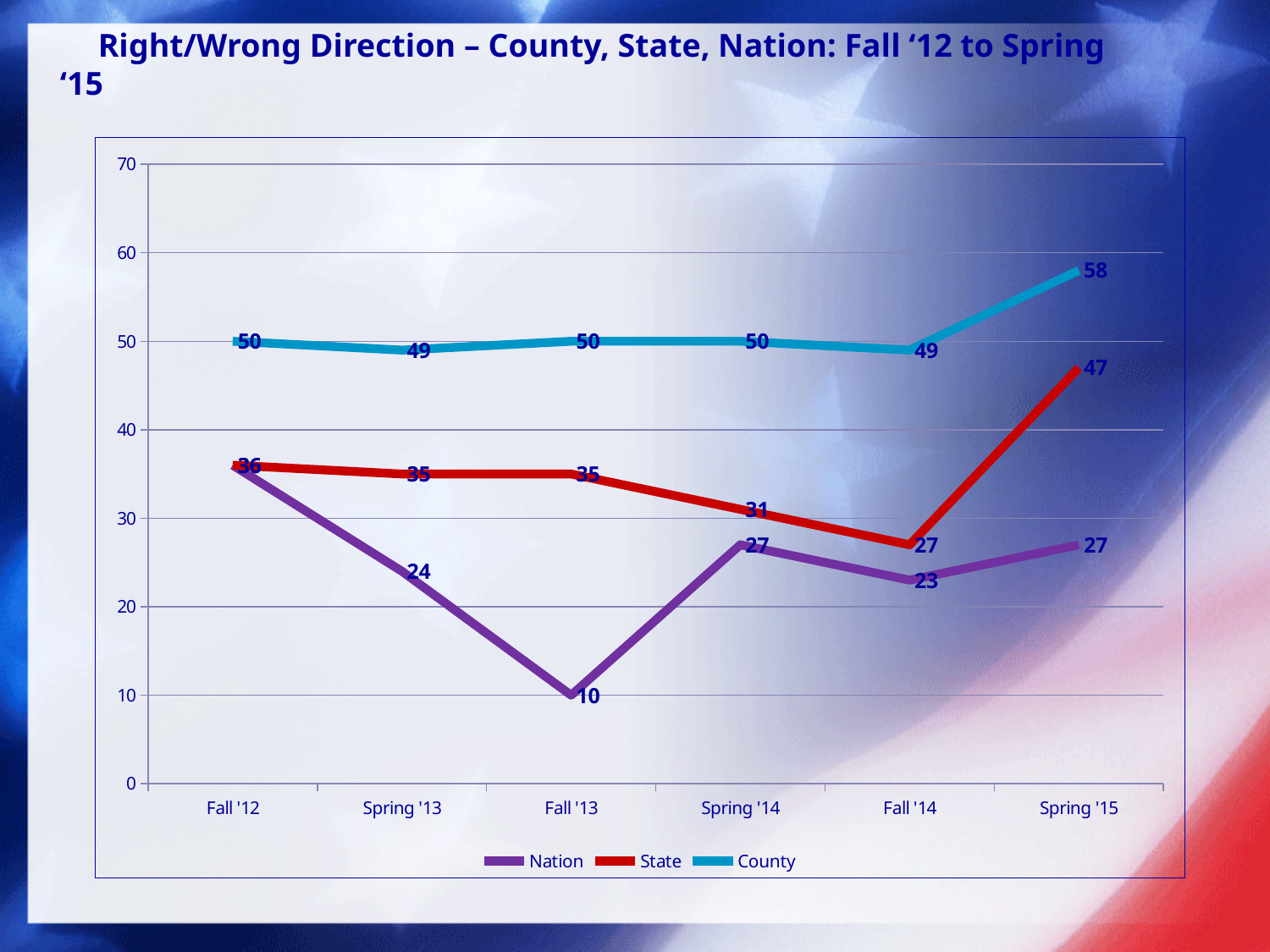
What is the Nation value for Fall '13? 10 Which is larger in Fall '14, the State value or the Nation value? State How many time points are shown on the x axis? 6 At which time point is the County series highest? Spring '15 Which colour represents the County series? Blue What is the County value for Spring '15? 58 How many series does the legend list? 3 What type of chart is shown on the slide? Line chart At which time point is the Nation series lowest? Fall '13 What is the State value for Spring '14? 31 Does the State series rise or fall from Fall '14 to Spring '15? Rise What is the difference between the State and Nation values in Spring '15? 20